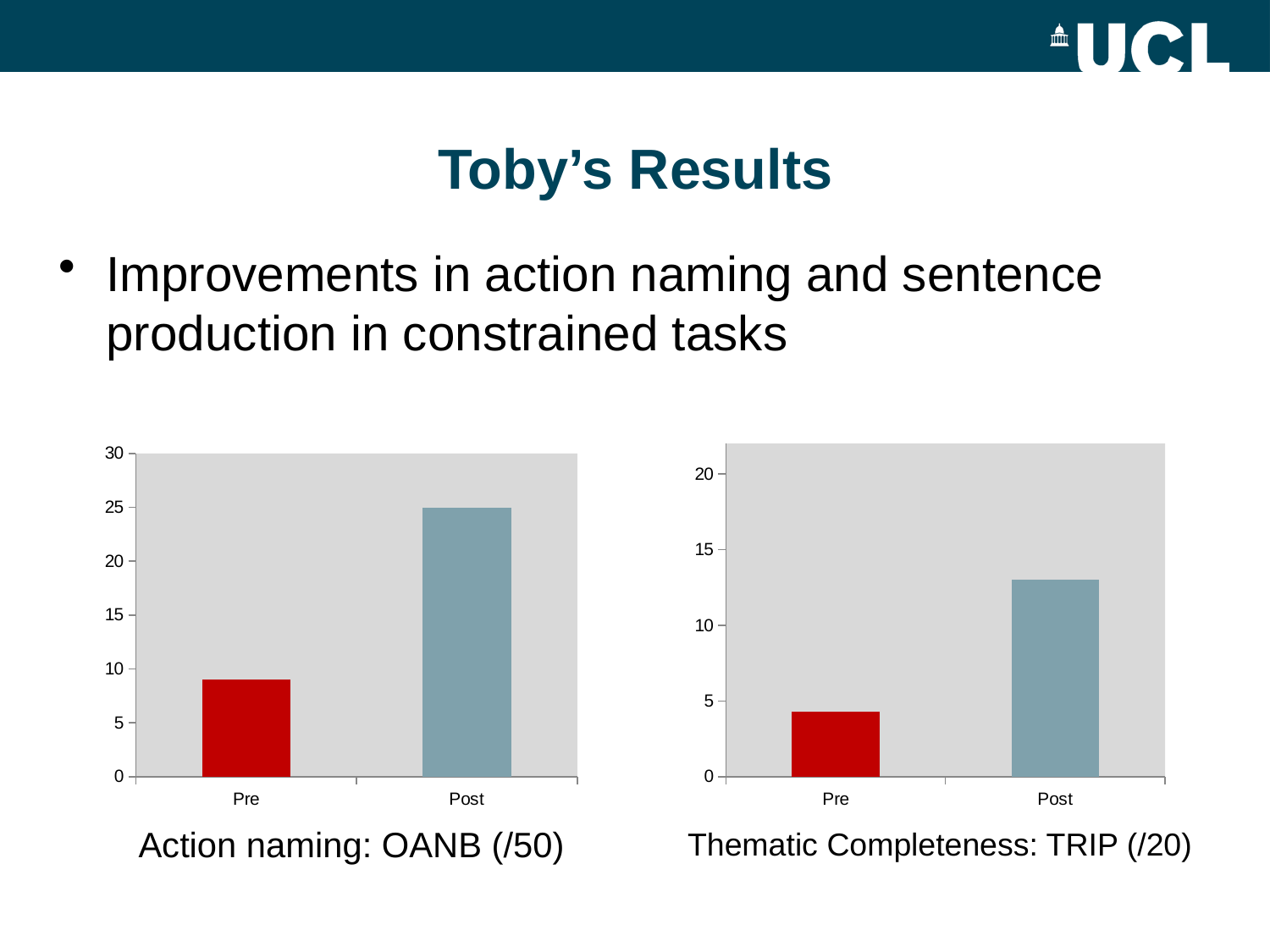
In the right chart (Thematic Completeness: TRIP), is the value for Post greater or less than 15? less In the right chart (Thematic Completeness: TRIP), is the value for Post greater or less than 10? greater What kind of chart is the left chart (Action naming: OANB)? bar chart In the right chart (Thematic Completeness: TRIP), is the value for Pre greater or less than 5? less In the left chart (Action naming: OANB), what colour is the Pre bar? red What is the caption under the right chart? Thematic Completeness: TRIP (/20) In the right chart (Thematic Completeness: TRIP), which category has the lowest value? Pre Do the values in the left chart (Action naming: OANB) rise or fall from Pre to Post? rise How many categories are shown on the x axis of the right chart (Thematic Completeness: TRIP)? 2 In the left chart (Action naming: OANB), which category has the higher value, Pre or Post? Post In the left chart (Action naming: OANB), what is the value for Post? 25